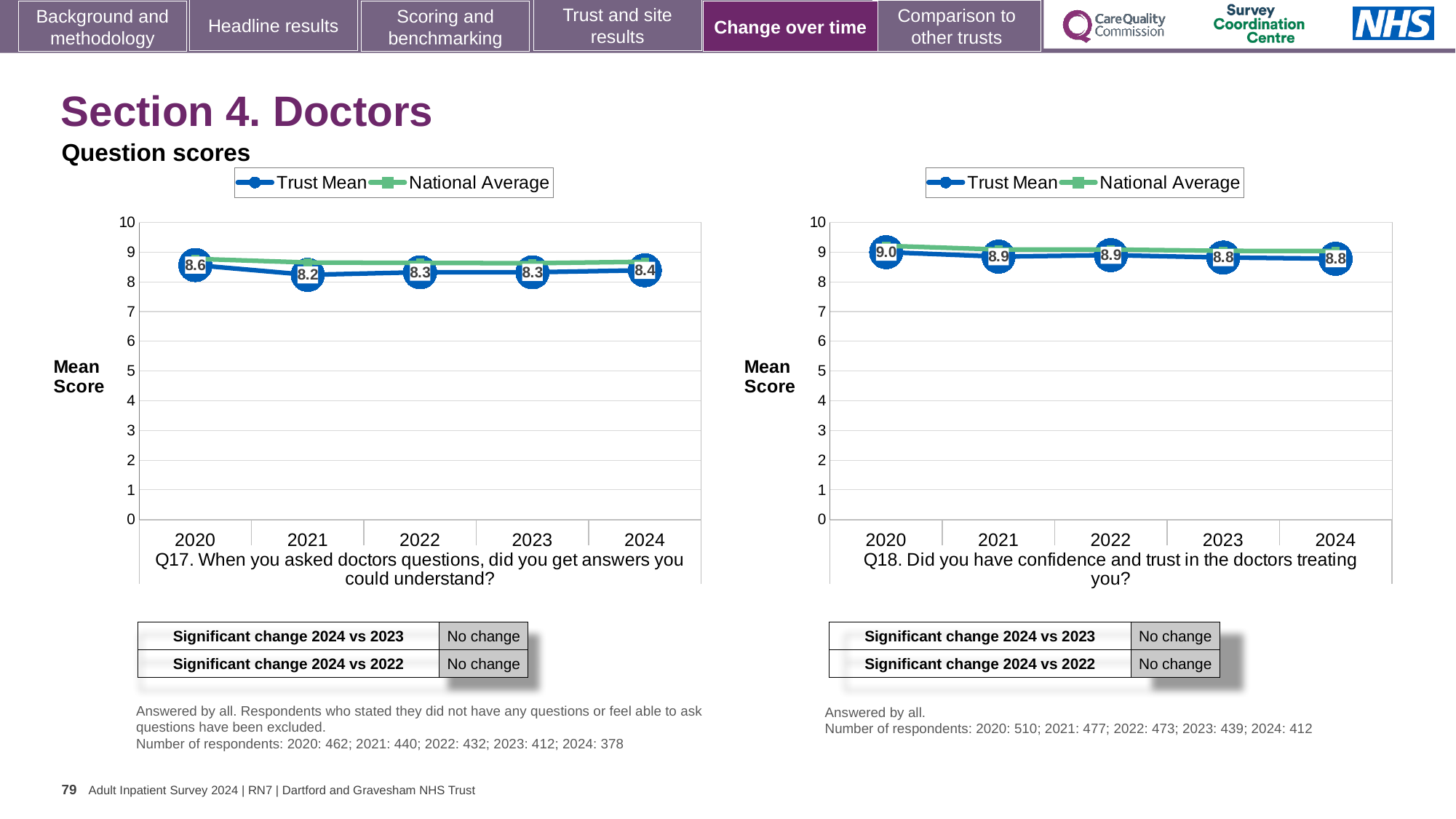
In the Q17 chart on the left, what is the Trust Mean score for 2020? 8.6 In the Q18 chart on the right, what is the Trust Mean score for 2020? 9.0 In the Q18 chart on the right, which year has the highest Trust Mean score? 2020 In the Q17 chart on the left, what is the difference between the Trust Mean scores for 2020 and 2021? 0.4 How many series does the legend of the Q17 chart on the left list? 2 In the Q17 chart on the left, which year has the highest Trust Mean score? 2020 In the Q18 chart on the right, what is the Trust Mean score for 2023? 8.8 In the Q18 chart on the right, what is the difference between the Trust Mean scores for 2020 and 2024? 0.2 In the Q18 chart on the right, how many years are plotted on the x axis? 5 In the Q17 chart on the left, is the National Average value for 2020 greater or less than 8? greater In the Q17 chart on the left, which year has the lowest Trust Mean score? 2021 In the Q17 chart on the left, what is the Trust Mean score for 2024? 8.4